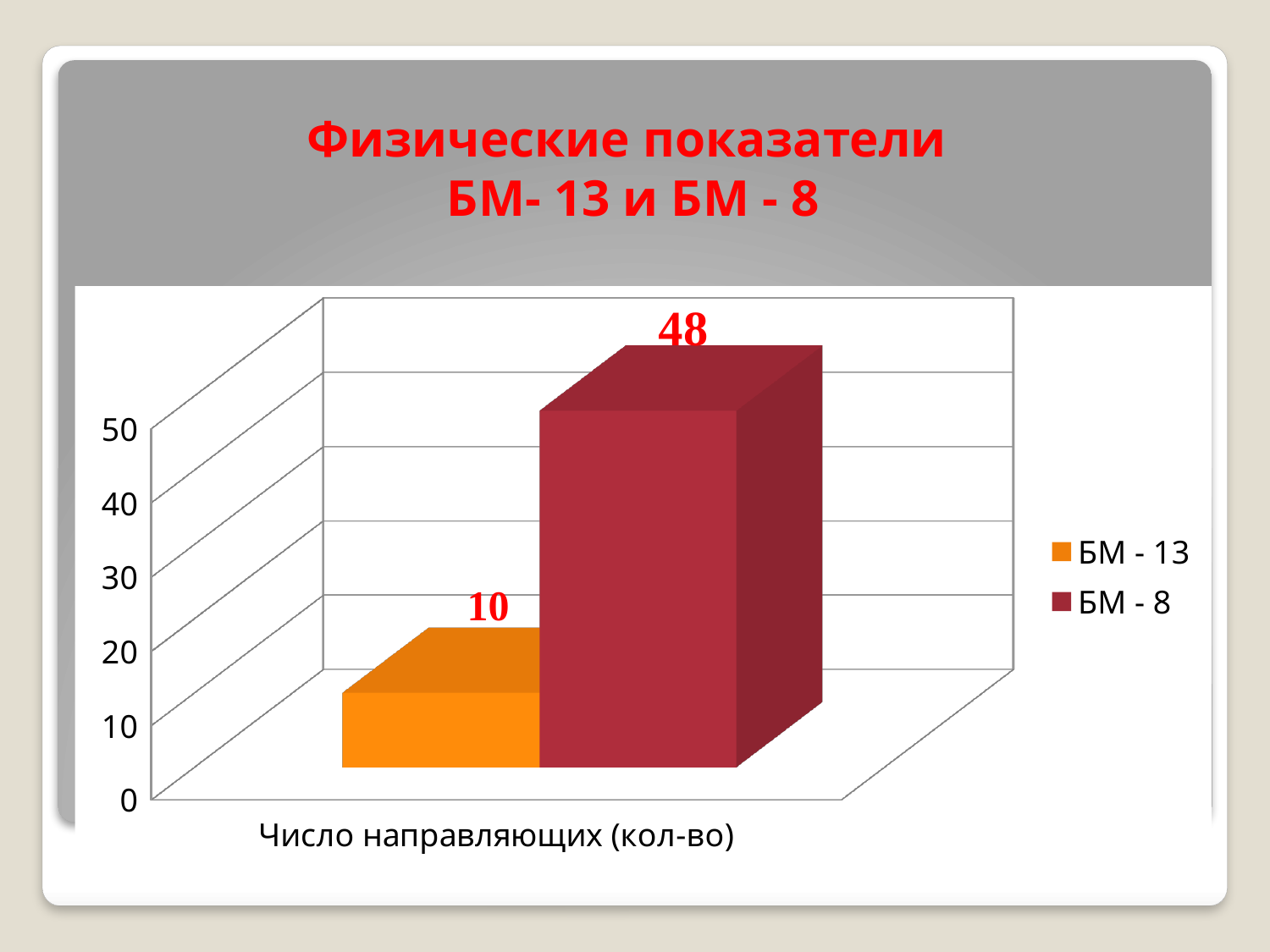
Which series has the higher value, БМ - 13 or БМ - 8? БМ - 8 What is the value for БМ - 8 in the chart? 48 What is the category label shown on the x axis of the chart? Число направляющих (кол-во) Is the value for БМ - 8 greater or less than 40? greater What is the value for БМ - 13 in the chart? 10 What colour is the bar for БМ - 13? orange What is the highest value shown on the vertical axis of the chart? 50 What is the difference between the values for БМ - 8 and БМ - 13? 38 Is the value for БМ - 13 greater or less than 20? less Which series has the lowest value in the chart? БМ - 13 What kind of chart is shown on the slide? bar chart How many series does the legend list? 2